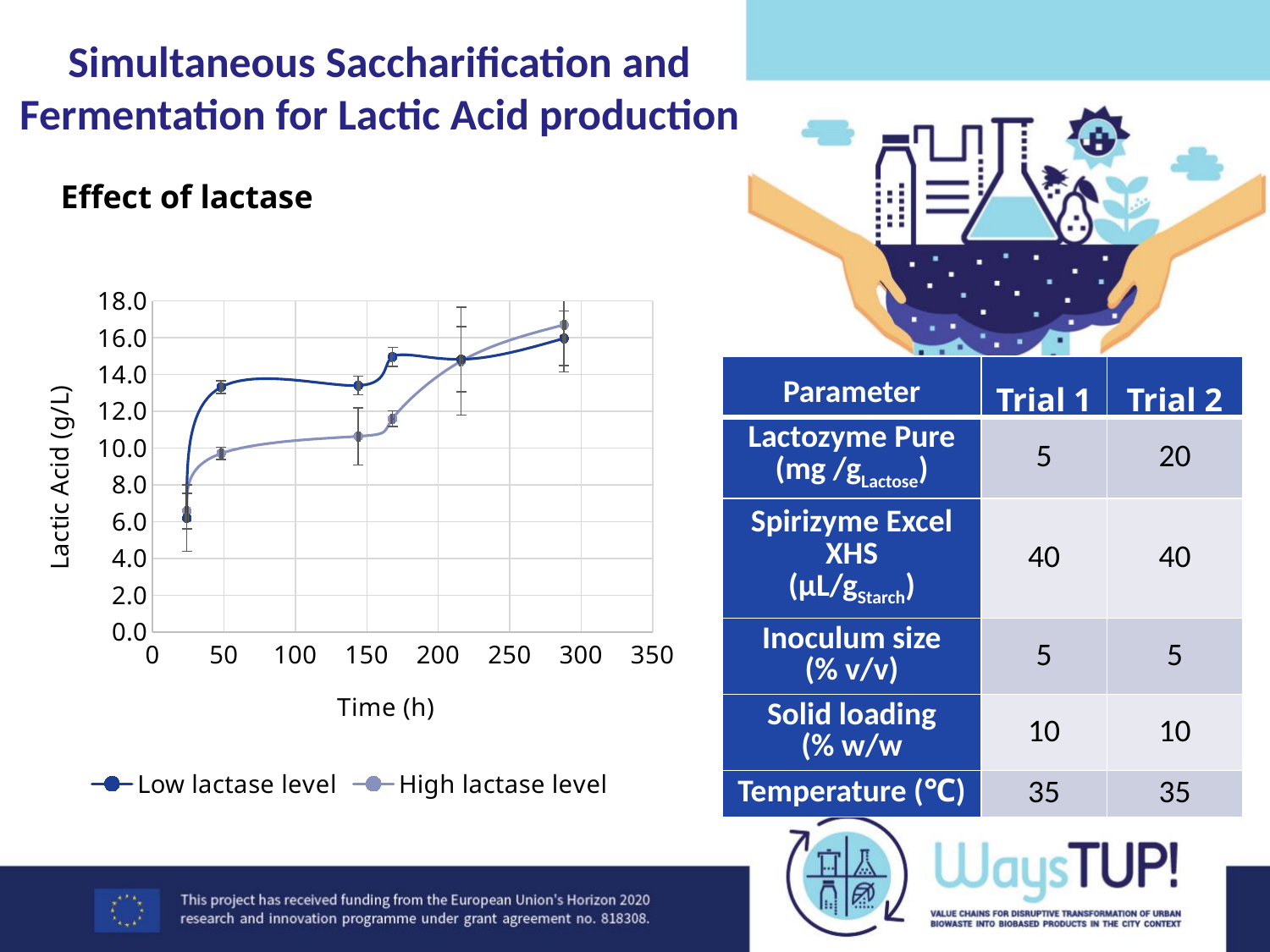
At about 50 h, which series has the higher lactic acid value, Low lactase level or High lactase level? Low lactase level Is the Low lactase level value at about 50 h greater or less than 12.0? greater Is the Low lactase level value at about 170 h greater or less than 14.0? greater What kind of chart is shown on the slide? line chart What is the label of the y axis of the chart? Lactic Acid (g/L) How many data points are plotted for the Low lactase level series? 6 Is the High lactase level value at about 50 h greater or less than 8.0? greater Overall, do the lactic acid values rise or fall as time increases? rise How many series does the chart legend list? 2 What are the two series named in the chart legend? Low lactase level and High lactase level At about 145 h, which series has the higher lactic acid value, Low lactase level or High lactase level? Low lactase level